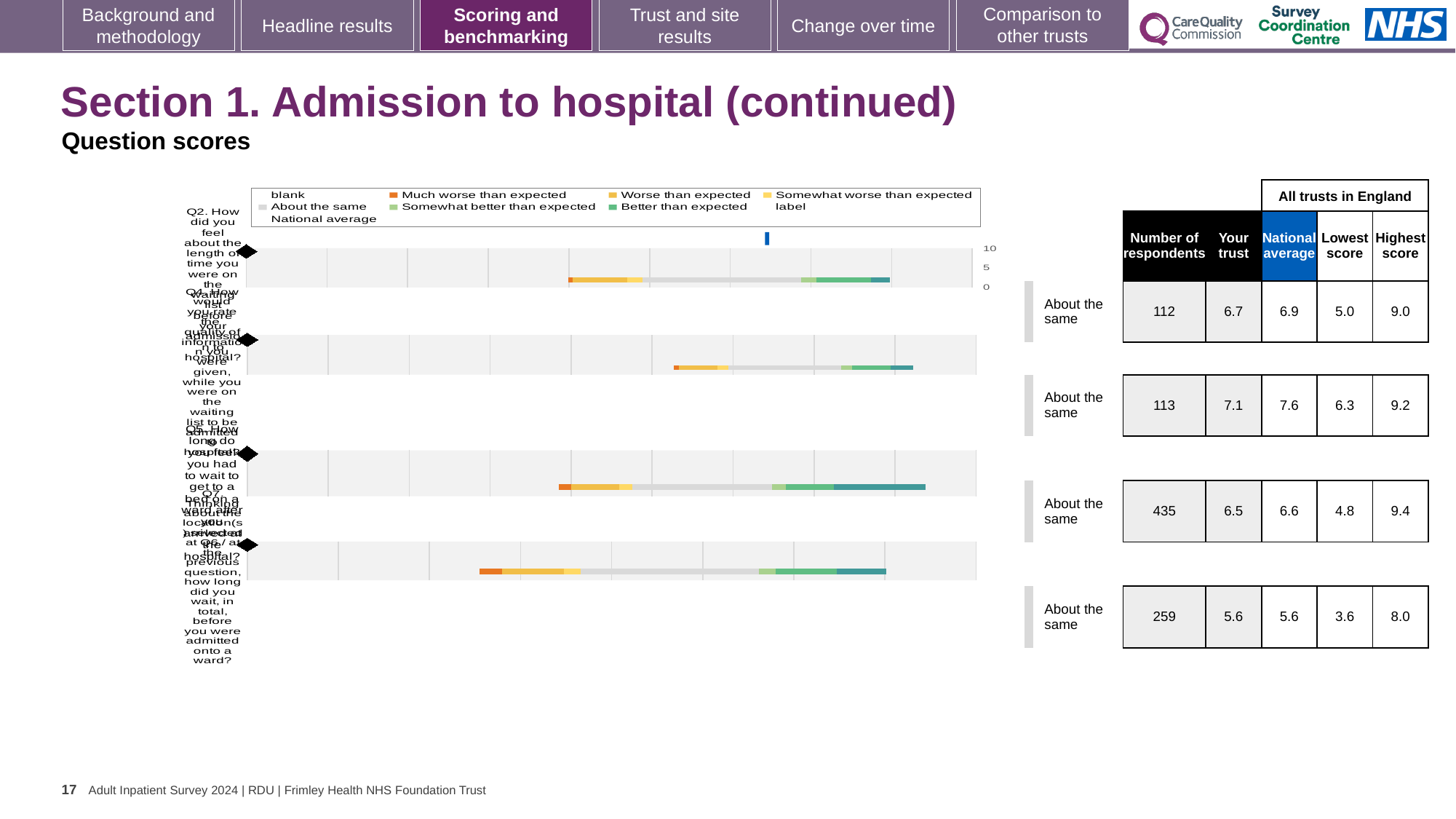
In the table beside the chart, for the second question row, which is larger: the 'Your trust' score or the national average? National average What is the highest value shown on the chart's score axis? 10 In the table beside the chart, what is the highest score for the fourth question row? 8.0 How many entries does the chart legend list? 9 In the table beside the chart, which question row has the largest number of respondents? the third row (435) How many question rows (bars) are plotted in the chart? 4 What kind of chart is shown on the slide? bar chart In the table beside the chart, what is the number of respondents for the first question row? 112 In the table beside the chart, what is the 'Your trust' score for the first question row? 6.7 In the table beside the chart, what is the difference between the national average and the 'Your trust' score for the second question row? 0.5 What colour represents 'Much worse than expected' in the chart legend? orange In the table beside the chart, what is the national average for the second question row? 7.6